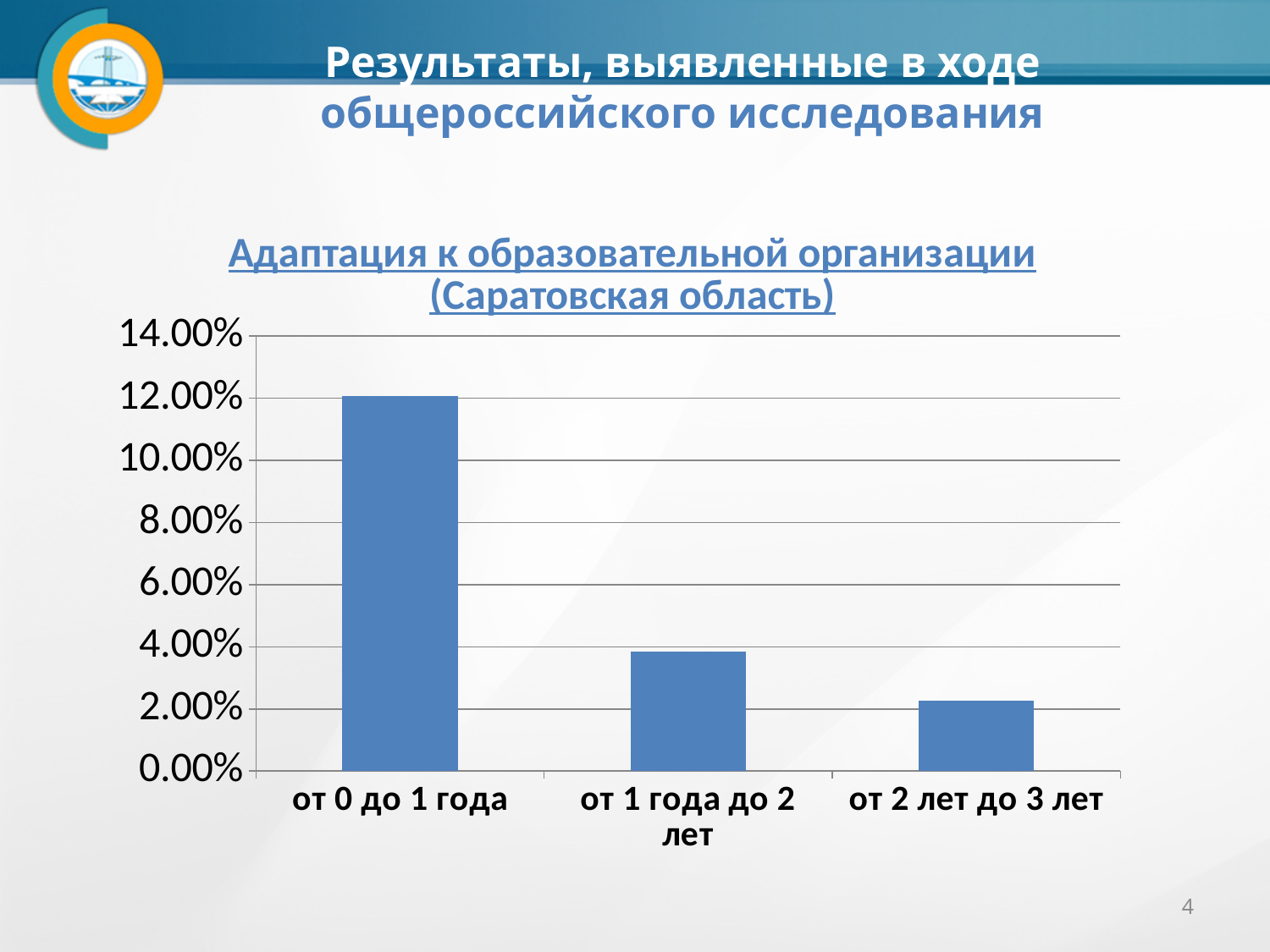
What kind of chart is shown on the slide? bar chart Which is larger, the value for "от 0 до 1 года" or the value for "от 1 года до 2 лет"? от 0 до 1 года Do the values rise or fall from left to right along the x axis? fall Is the value for "от 2 лет до 3 лет" greater or less than 4.00%? less How many categories are shown on the x axis of the chart? 3 Which category has the highest value in the chart? от 0 до 1 года Is the value for "от 0 до 1 года" greater or less than 14.00%? less Is the value for "от 1 года до 2 лет" greater or less than 2.00%? greater Which category has the lowest value in the chart? от 2 лет до 3 лет What is the title of the chart? Адаптация к образовательной организации (Саратовская область)